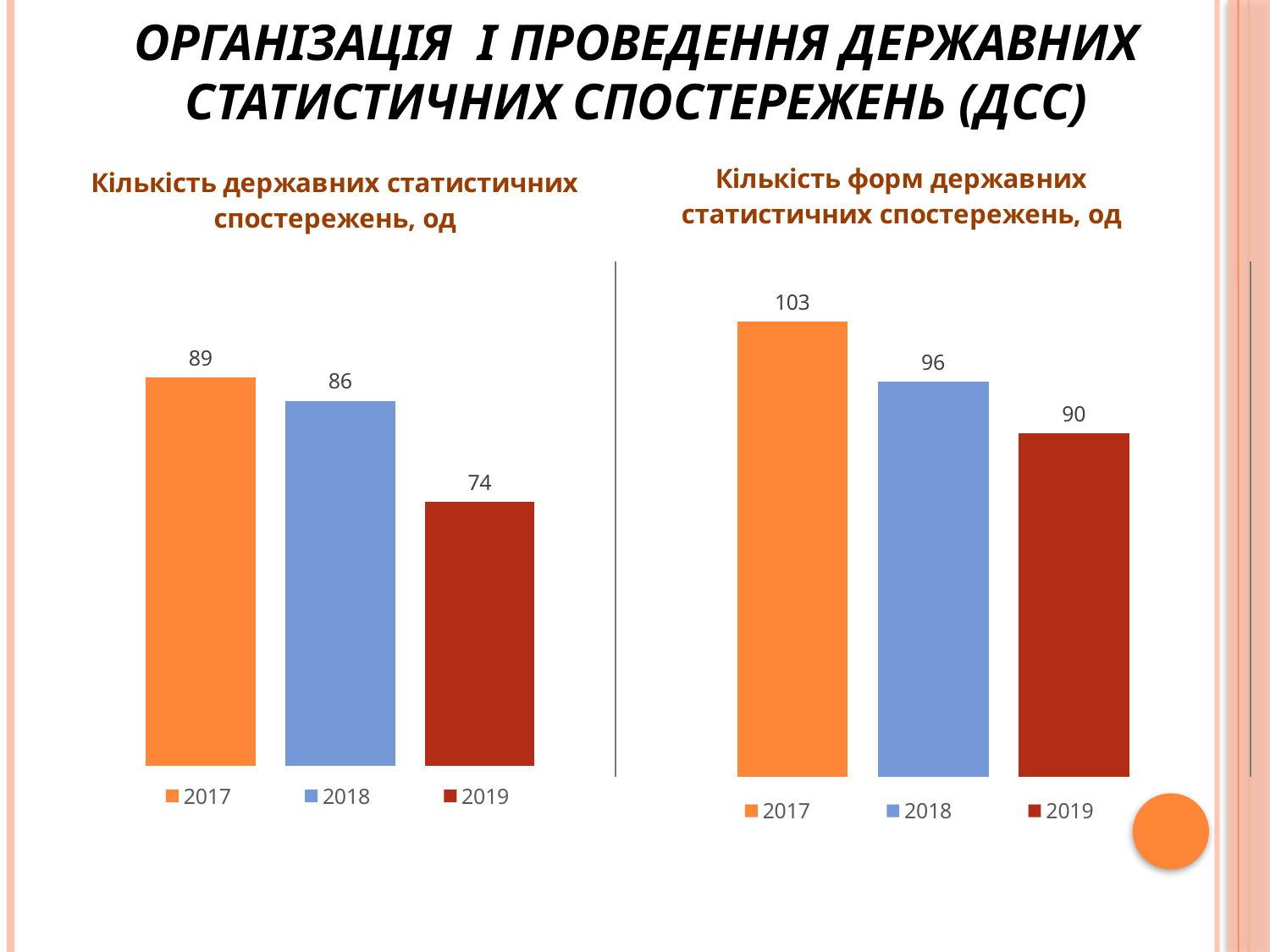
In the right chart (Кількість форм державних статистичних спостережень, од), which is larger, the value for 2018 or 2019? 2018 In the left chart (Кількість державних статистичних спостережень, од), what is the value for 2019? 74 In the right chart (Кількість форм державних статистичних спостережень, од), what is the value for 2018? 96 In the left chart (Кількість державних статистичних спостережень, од), what is the difference between the values for 2017 and 2019? 15 In the right chart (Кількість форм державних статистичних спостережень, од), what is the difference between the values for 2017 and 2019? 13 In the right chart (Кількість форм державних статистичних спостережень, од), which year has the highest value? 2017 In the left chart (Кількість державних статистичних спостережень, од), which year has the lowest value? 2019 In the left chart (Кількість державних статистичних спостережень, од), do the values rise or fall from 2017 to 2019? Fall How many bars are shown in the left chart (Кількість державних статистичних спостережень, од)? 3 In the left chart (Кількість державних статистичних спостережень, од), what is the value for 2017? 89 What kind of chart is the right chart (Кількість форм державних статистичних спостережень, од)? Bar chart How many entries does the legend of the right chart (Кількість форм державних статистичних спостережень, од) list? 3